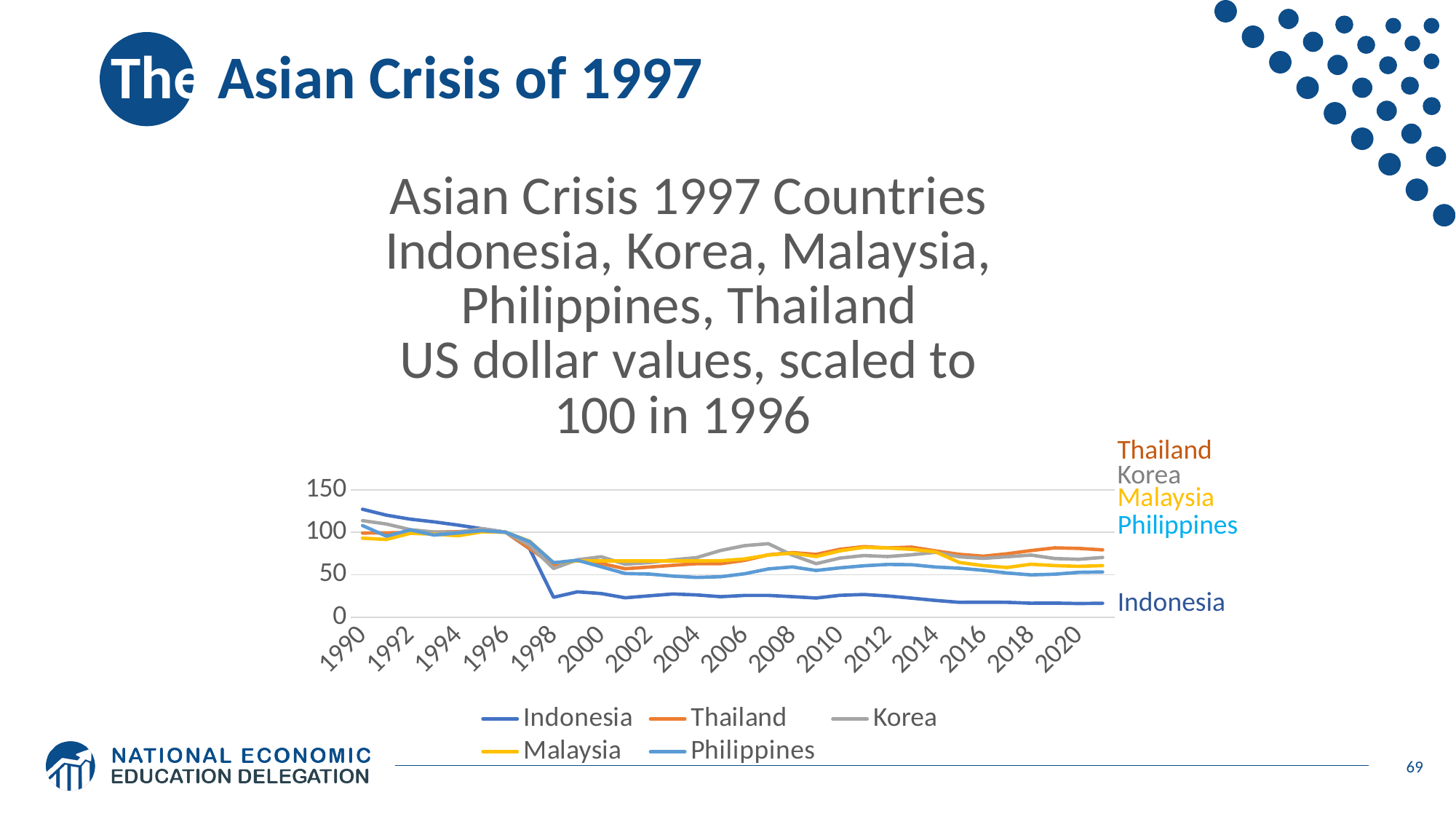
What kind of chart is shown on the slide? line chart Which countries are listed in the chart's legend? Indonesia, Thailand, Korea, Malaysia, Philippines Is the value for Thailand in 2020 greater or less than 50? greater What is the value for every country in 1996? 100 How many series does the chart's legend list? 5 Which country has the lowest value in 2020? Indonesia Is the value for Indonesia in 1990 greater or less than 100? greater Is the value for Indonesia in 2020 greater or less than 50? less According to the chart title, in which year are the US dollar values scaled to 100? 1996 Which is larger in 2020, the value for Thailand or the value for Indonesia? Thailand Which country has the highest value in 1990? Indonesia Does the value for Indonesia rise or fall between 1996 and 2020? fall